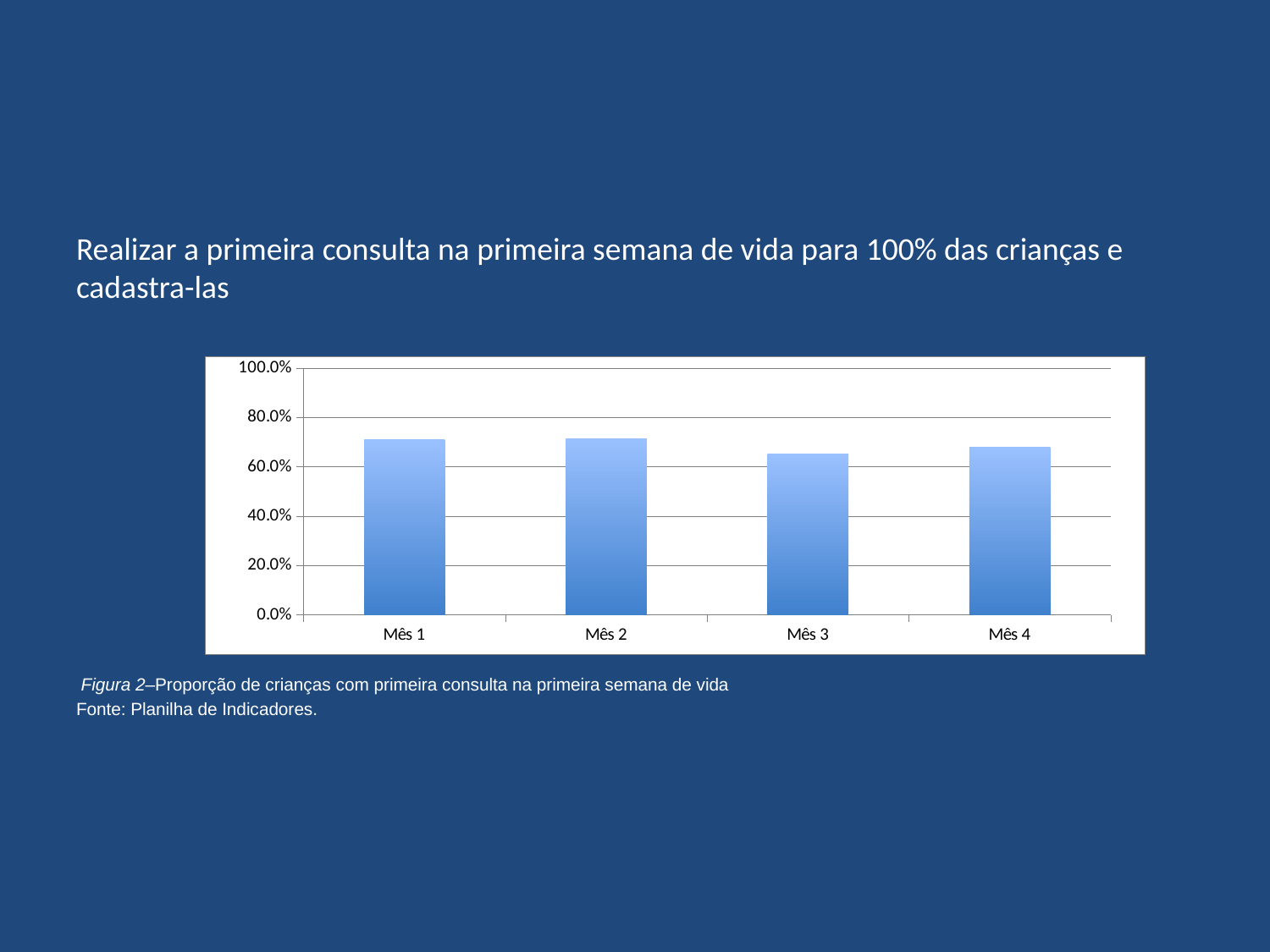
Is the value for Mês 2 greater or less than 80.0%? less Is the value for Mês 1 greater or less than 60.0%? greater Which is larger, the value for Mês 1 or the value for Mês 3? Mês 1 According to the caption below the chart, what does Figura 2 show? Proporção de crianças com primeira consulta na primeira semana de vida What kind of chart is shown on the slide? bar chart How many categories (months) are shown on the x axis of the chart? 4 Which month has the lowest bar in the chart? Mês 3 What is the highest value shown on the y axis of the chart? 100.0% Which is larger, the value for Mês 2 or the value for Mês 3? Mês 2 Is the value for Mês 3 greater or less than 60.0%? greater